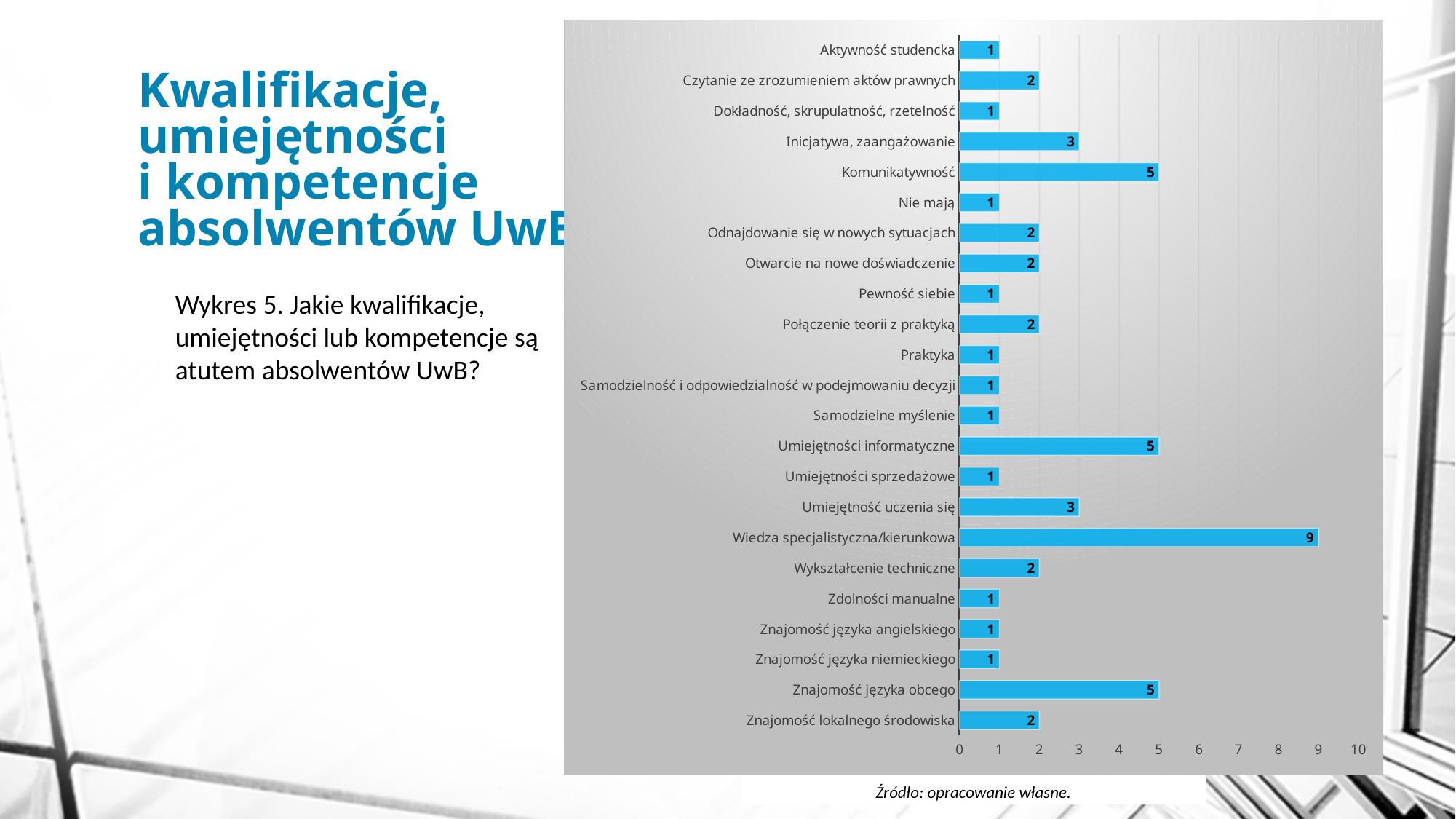
What value is shown for Wiedza specjalistyczna/kierunkowa? 9 Is the value for Znajomość języka obcego greater or less than 4? greater What is the difference between the values for Wiedza specjalistyczna/kierunkowa and Umiejętności informatyczne? 4 What value is shown for Znajomość lokalnego środowiska? 2 How many categories are shown on the chart? 23 What value is shown for Komunikatywność? 5 Which category has the highest value? Wiedza specjalistyczna/kierunkowa Which is larger, the value for Umiejętność uczenia się or the value for Wykształcenie techniczne? Umiejętność uczenia się How many categories have a value of 1? 11 What is the highest value shown on the horizontal axis? 10 What value is shown for Inicjatywa, zaangażowanie? 3 What kind of chart is shown on the slide? bar chart